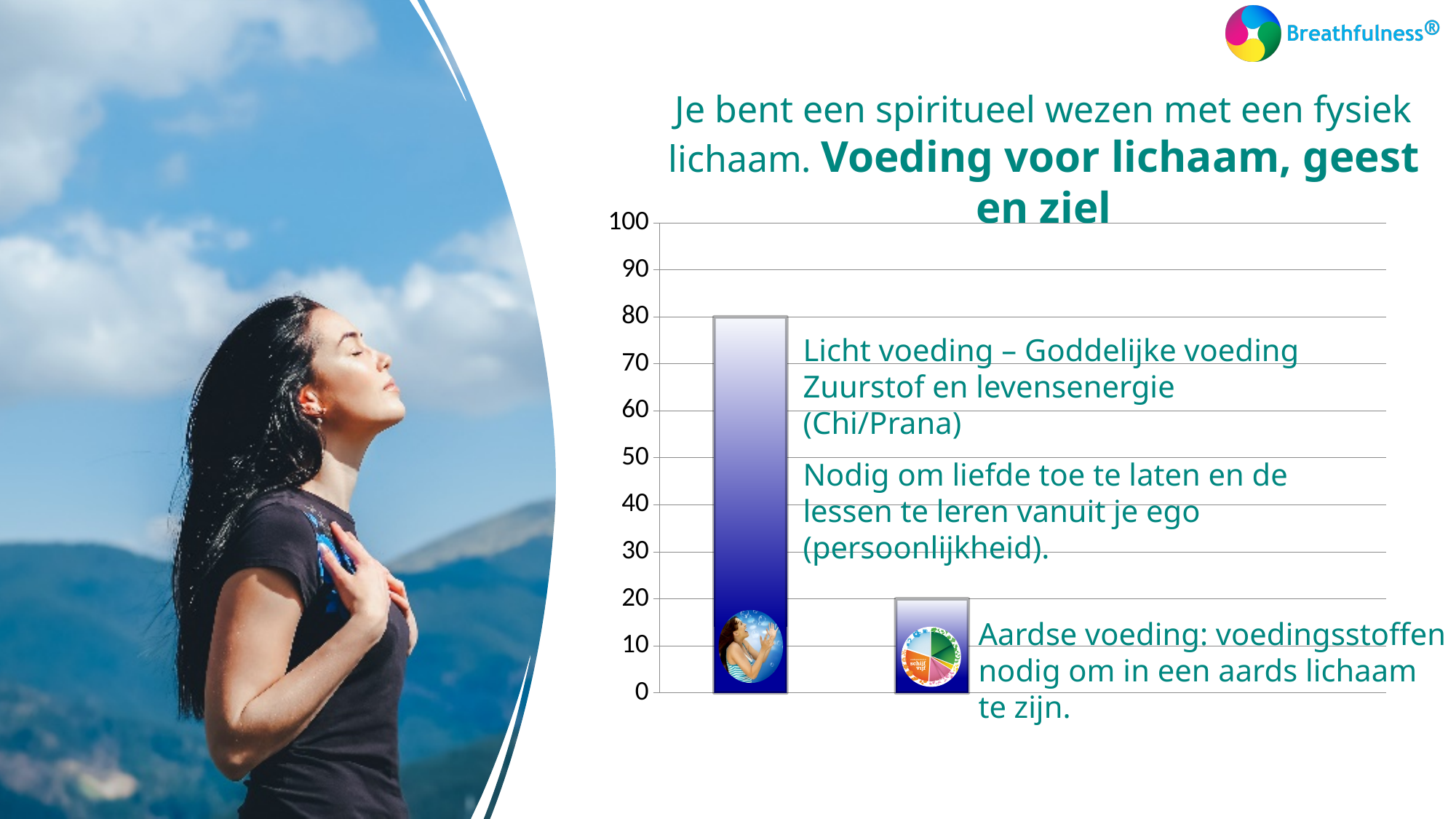
How many bars does the chart show? 2 Do the bar values rise or fall from left to right? fall What kind of chart is shown on the slide? bar chart What is the maximum value shown on the vertical axis? 100 Which bar is the lowest in the chart? the right bar (Aardse voeding) What value does the left bar (Licht voeding – Goddelijke voeding) reach on the axis? 80 Which bar is taller, the left one (Licht voeding) or the right one (Aardse voeding)? the left one (Licht voeding) Is the value of the left bar (Licht voeding) greater or less than 50? greater What is the difference between the left bar (80) and the right bar (20)? 60 What value does the right bar (Aardse voeding) reach on the axis? 20 What is the total of the two bar values (80 and 20)? 100 Is the value of the right bar (Aardse voeding) greater or less than 30? less